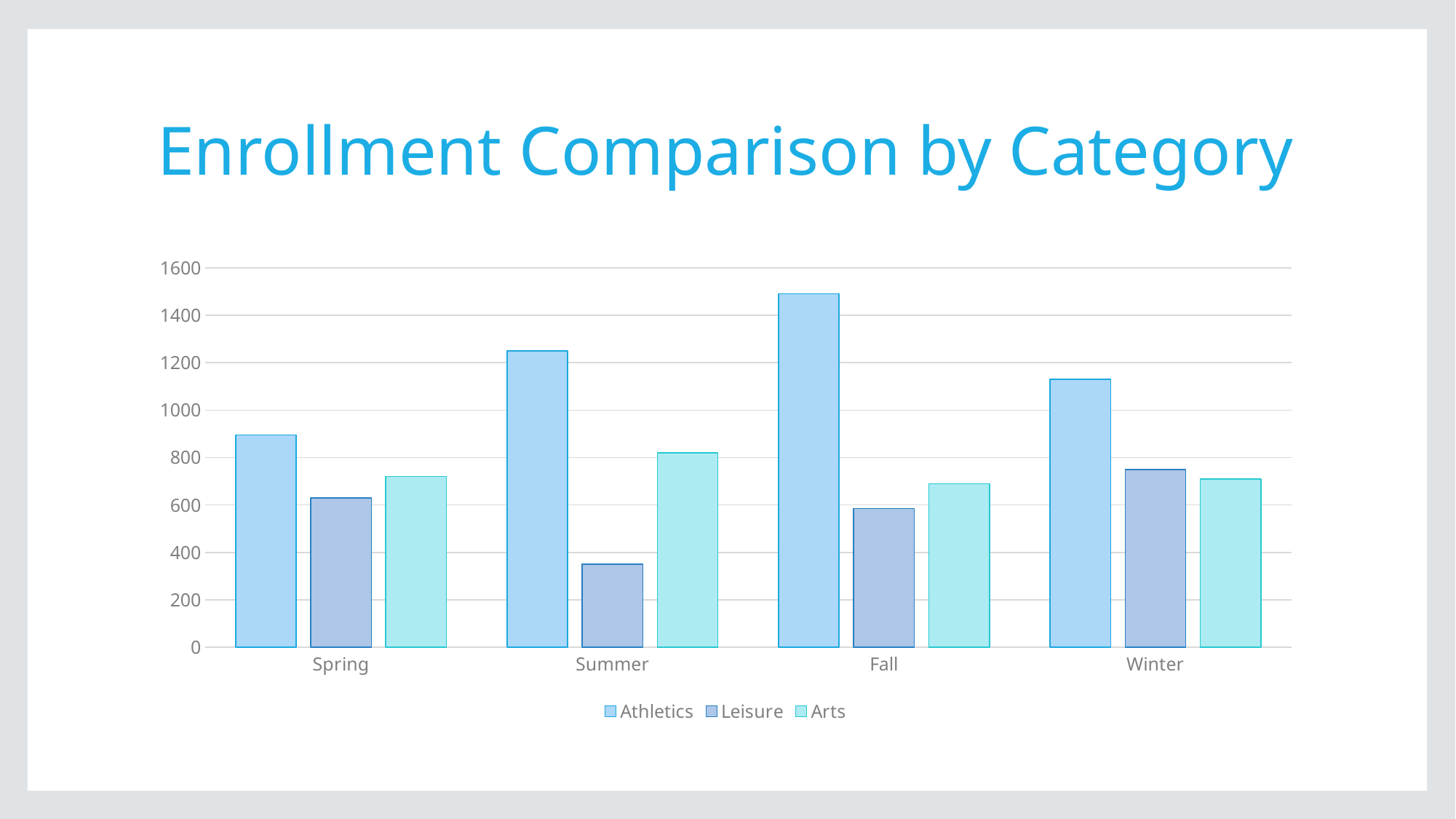
Is the value for Athletics in Fall greater or less than 1400? greater Is the value for Athletics in Spring greater or less than 1000? less What kind of chart is shown on the slide? bar chart How many seasons are shown on the x axis? 4 In Spring, which is larger: Leisure or Arts? Arts How many series does the legend list? 3 In Summer, which is larger: Athletics or Arts? Athletics Which series does the legend list first? Athletics In which season is the Athletics bar highest? Fall Is the value for Leisure in Winter greater or less than 600? greater In which season is the Leisure bar lowest? Summer